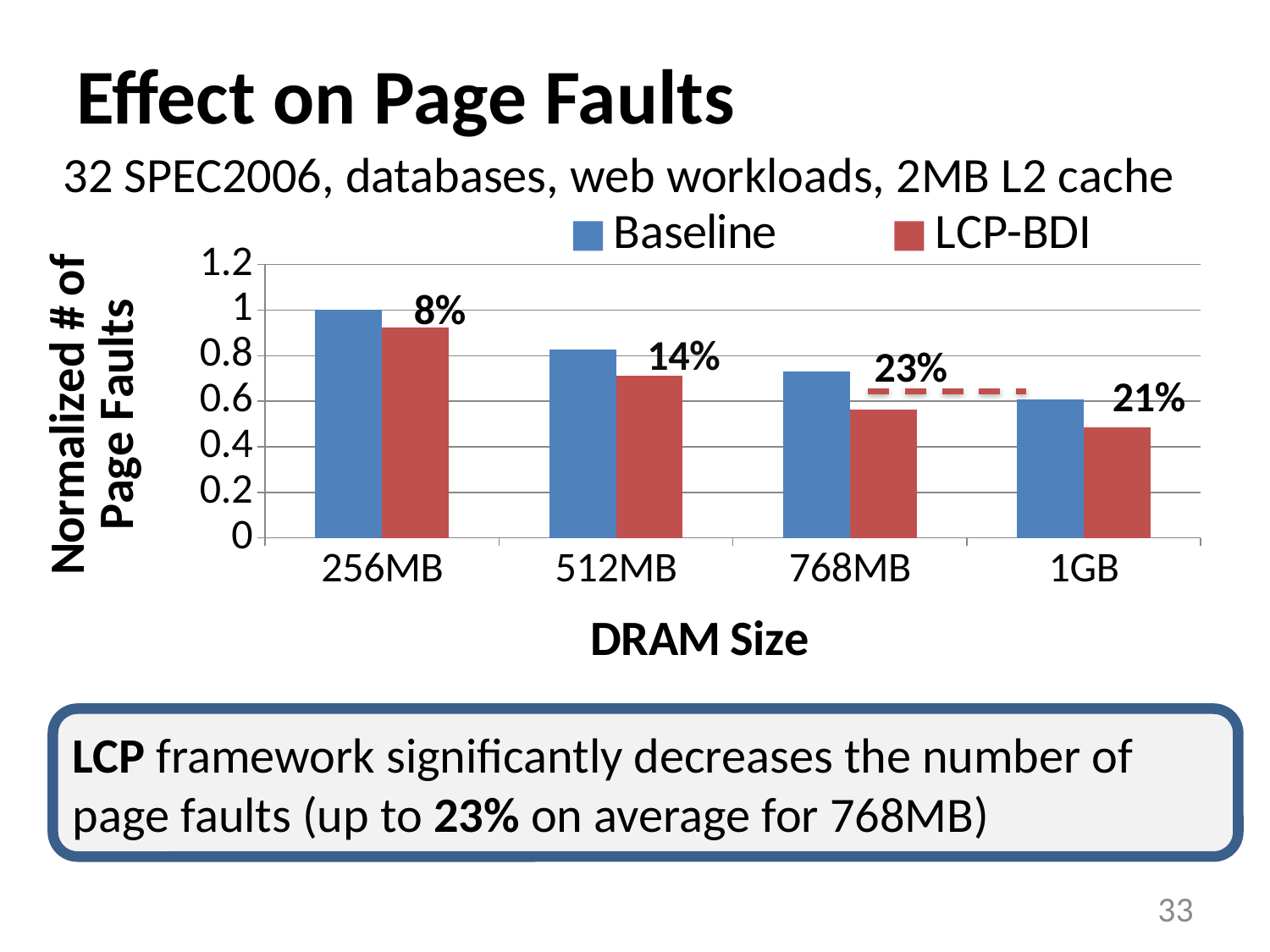
Which DRAM size has the largest labeled percentage reduction? 768MB How many DRAM size categories are shown on the x axis? 4 What percentage reduction is labeled above the 768MB bars? 23% Is the Baseline value for 768MB greater or less than 0.8? less How many series does the legend list? 2 Which DRAM size has the smallest labeled percentage reduction? 256MB What percentage reduction is labeled for 256MB? 8% What is the normalized number of page faults for Baseline at 256MB? 1 At 768MB, which series has the higher normalized number of page faults, Baseline or LCP-BDI? Baseline What kind of chart is shown on the slide? bar chart Is the LCP-BDI value for 1GB greater or less than 0.6? less Do the Baseline values rise or fall as DRAM size increases from 256MB to 1GB? fall